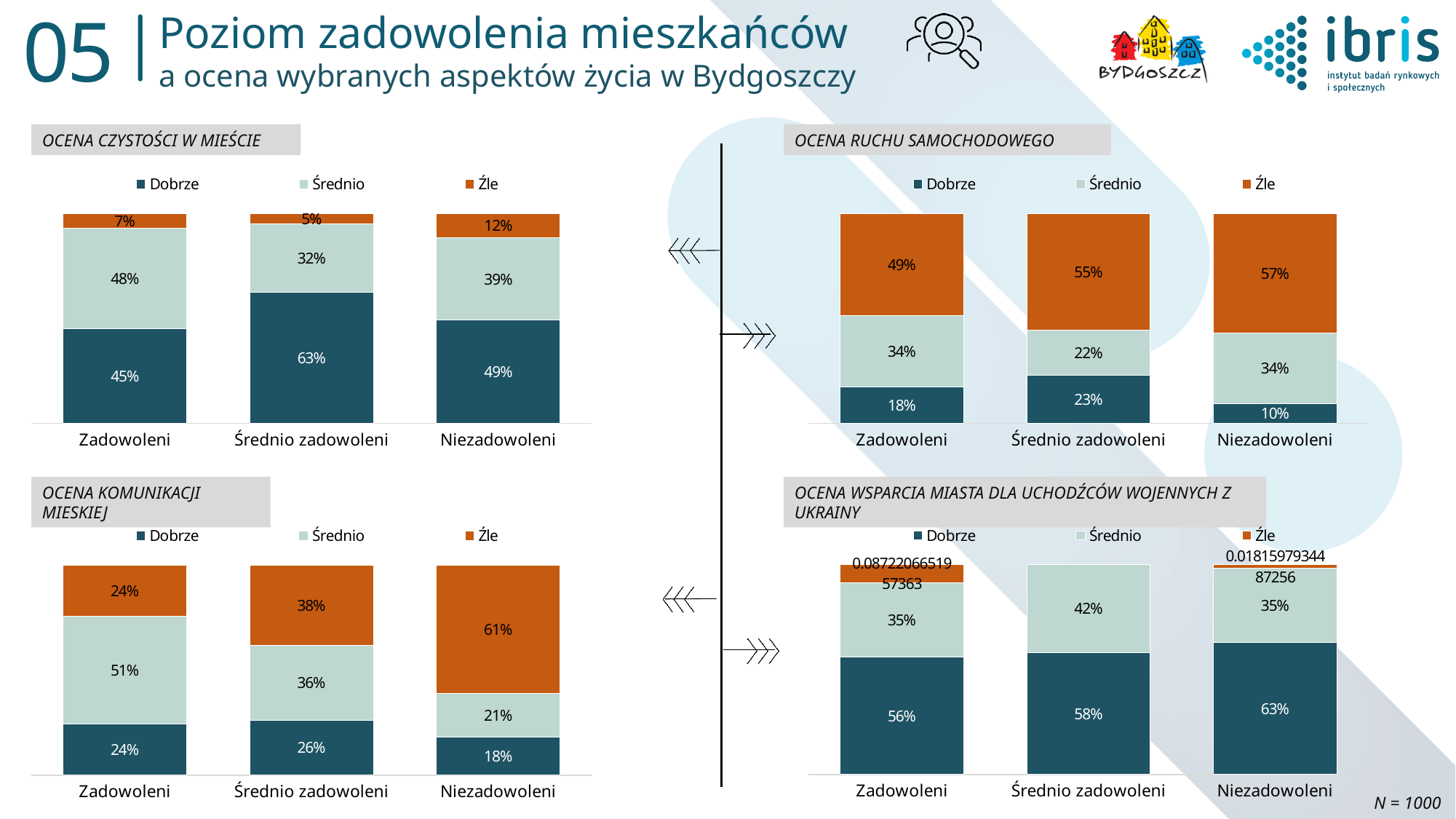
What kind of chart is the 'OCENA RUCHU SAMOCHODOWEGO' chart? Stacked bar chart In the 'OCENA KOMUNIKACJI MIESKIEJ' chart, how many categories are shown on the x axis? 3 In the 'OCENA KOMUNIKACJI MIESKIEJ' chart, what is the 'Źle' value for 'Niezadowoleni'? 61% In the 'OCENA KOMUNIKACJI MIESKIEJ' chart, what is the total of the stacked bar for 'Zadowoleni'? 99% In the 'OCENA RUCHU SAMOCHODOWEGO' chart, which category has the lowest 'Dobrze' value? Niezadowoleni In the 'OCENA WSPARCIA MIASTA DLA UCHODŹCÓW WOJENNYCH Z UKRAINY' chart, what is the 'Dobrze' value for 'Niezadowoleni'? 63% In the 'OCENA WSPARCIA MIASTA DLA UCHODŹCÓW WOJENNYCH Z UKRAINY' chart, how many series does the legend list? 3 In the 'OCENA CZYSTOŚCI W MIEŚCIE' chart, which category has the highest 'Źle' value? Niezadowoleni In the 'OCENA RUCHU SAMOCHODOWEGO' chart, is the 'Źle' value larger for 'Zadowoleni' or for 'Średnio zadowoleni'? Średnio zadowoleni In the 'OCENA CZYSTOŚCI W MIEŚCIE' chart, what is the difference between the 'Średnio' values for 'Zadowoleni' and 'Średnio zadowoleni'? 16% In the 'OCENA RUCHU SAMOCHODOWEGO' chart, what is the 'Źle' value for 'Niezadowoleni'? 57% In the 'OCENA CZYSTOŚCI W MIEŚCIE' chart, what is the 'Dobrze' value for 'Średnio zadowoleni'? 63%